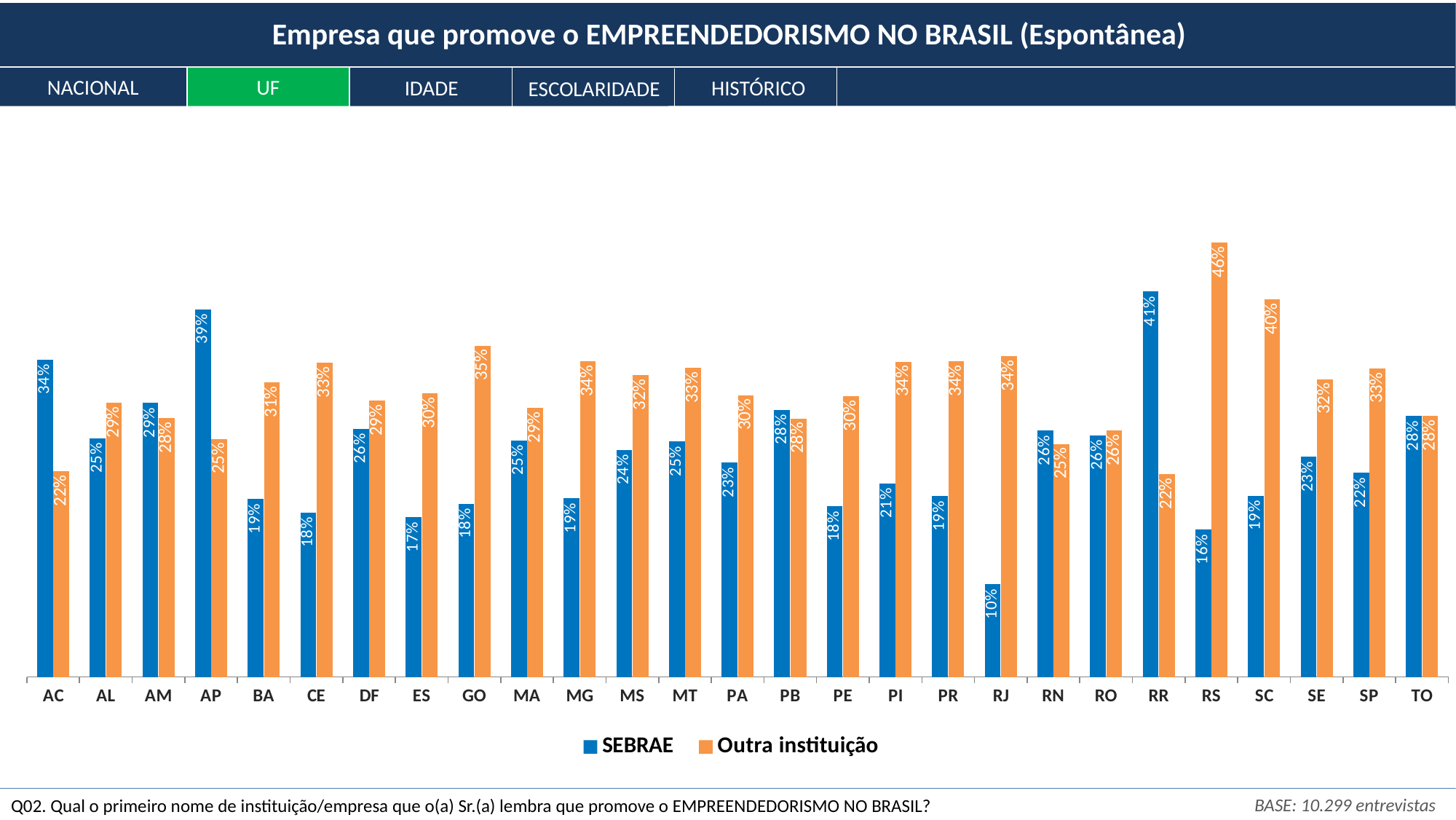
What is the title of the chart? Empresa que promove o EMPREENDEDORISMO NO BRASIL (Espontânea) For AP, which is larger: SEBRAE or Outra instituição? SEBRAE What is the SEBRAE value for RJ? 10% What is the difference between the Outra instituição and SEBRAE values for RS? 30% Which state has the lowest SEBRAE value? RJ Which state has the highest Outra instituição value? RS What type of chart is shown on the slide? bar chart How many states (UF categories) are shown on the x axis? 27 How many series does the legend list? 2 What is the difference between the SEBRAE values for RR and AC? 7% Which state has the highest SEBRAE value? RR What is the Outra instituição value for SC? 40%